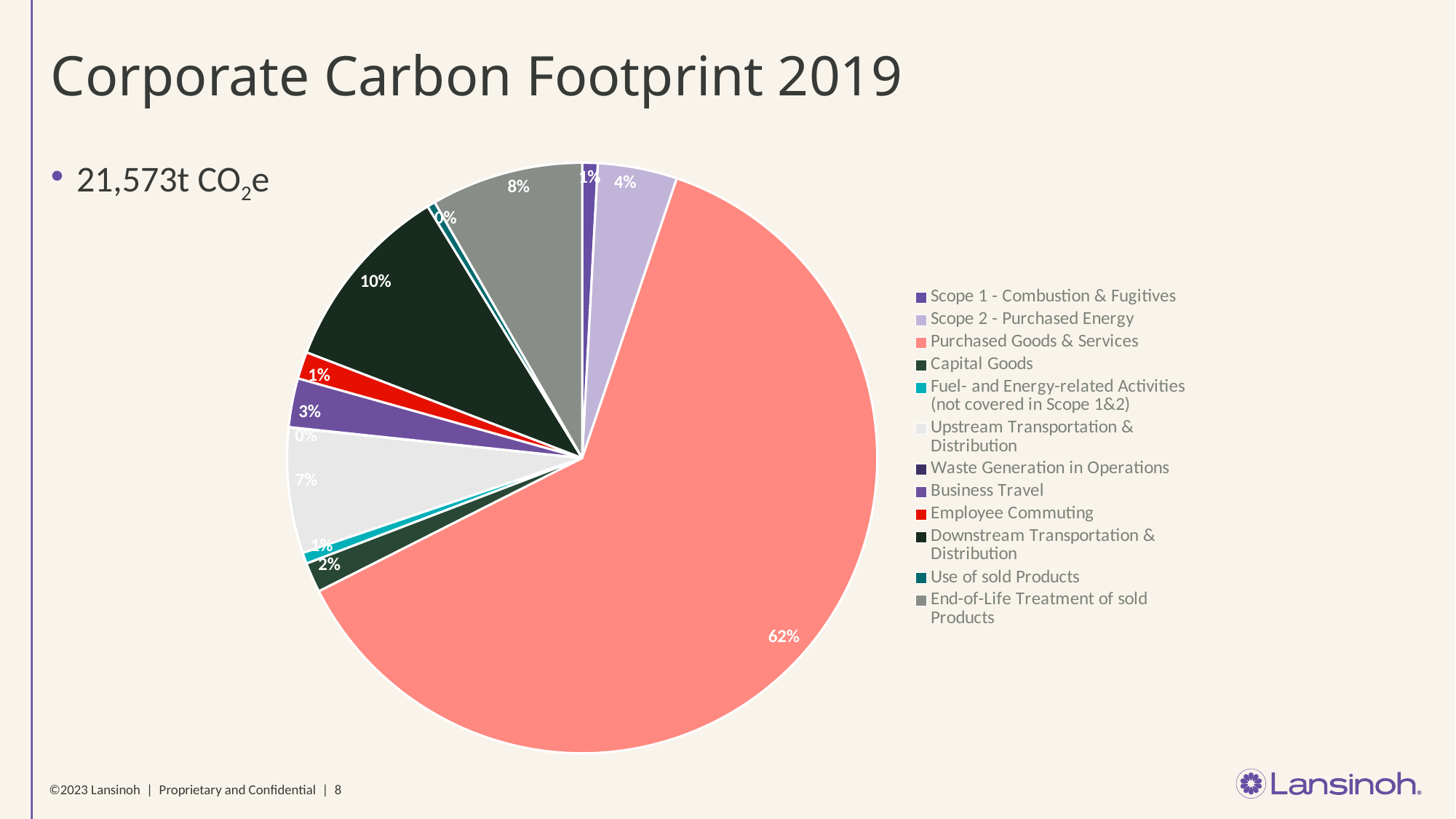
What percentage is shown for Scope 2 - Purchased Energy? 4% How many categories does the legend list? 12 What share of the pie does Purchased Goods & Services account for? 62% What is the difference in percentage points between Purchased Goods & Services and Downstream Transportation & Distribution? 52 Which has a larger share, End-of-Life Treatment of sold Products or Upstream Transportation & Distribution? End-of-Life Treatment of sold Products What percentage is shown for Business Travel? 3% What percentage is shown for Downstream Transportation & Distribution? 10% What is the title of the slide containing the chart? Corporate Carbon Footprint 2019 What percentage is shown for End-of-Life Treatment of sold Products? 8% What type of chart is shown on the slide? pie chart What percentage is shown for Upstream Transportation & Distribution? 7% Which category has the largest share of the pie? Purchased Goods & Services